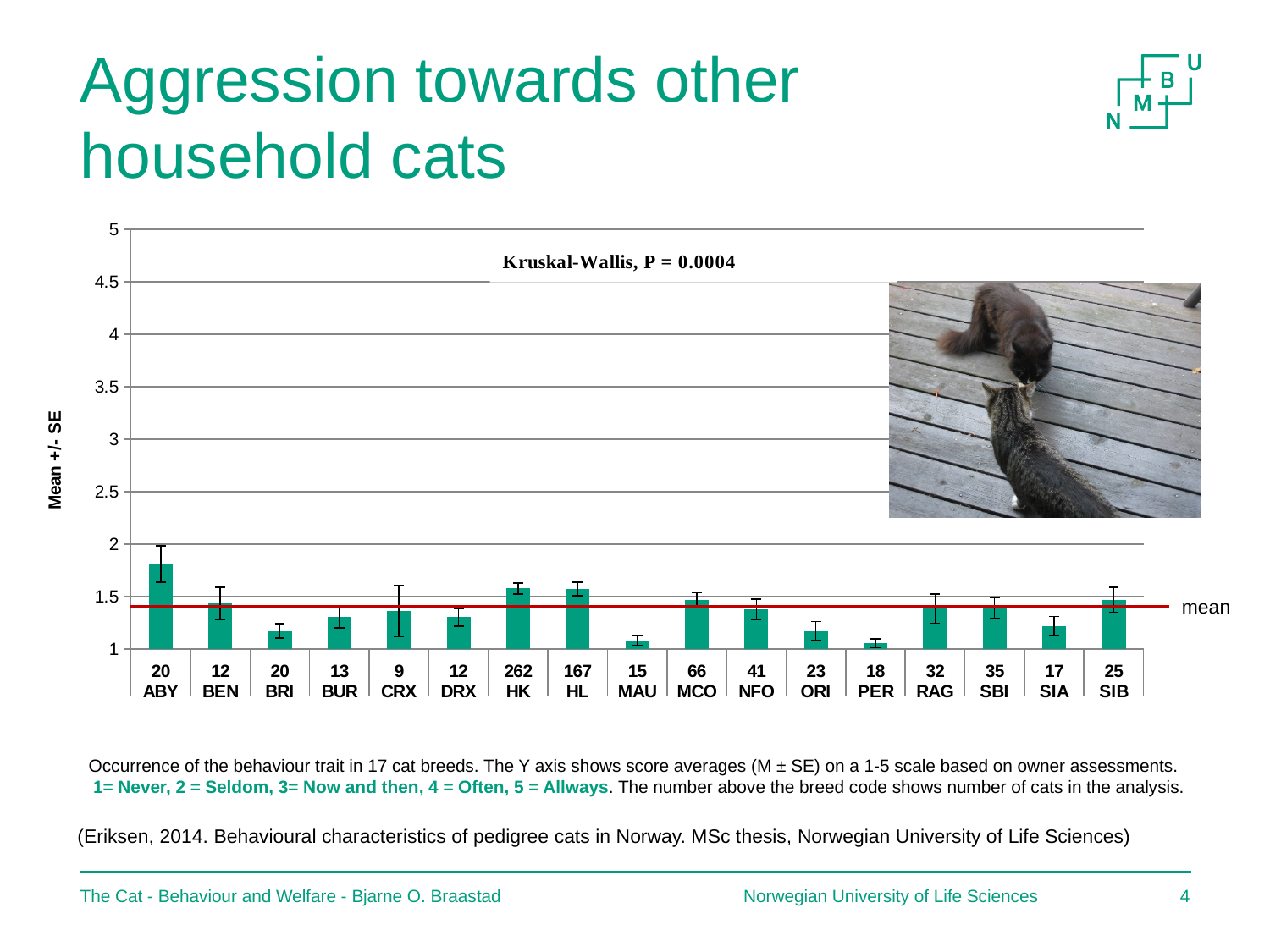
Is the mean score for ABY greater or less than 2? less Is the mean score for HK greater or less than 1.5? greater Is the mean score for MAU greater or less than 1.5? less Which breed has the highest mean aggression score in the chart? ABY What kind of chart is shown on the slide? bar chart How many cats were included in the analysis for the HK breed? 262 Which breed has the largest number of cats in the analysis? HK How many cat breeds are shown on the x axis of the chart? 17 Which has the larger mean score, ABY or PER? ABY What is the label on the y axis of the chart? Mean +/- SE How many more cats were analysed for HK than for HL? 95